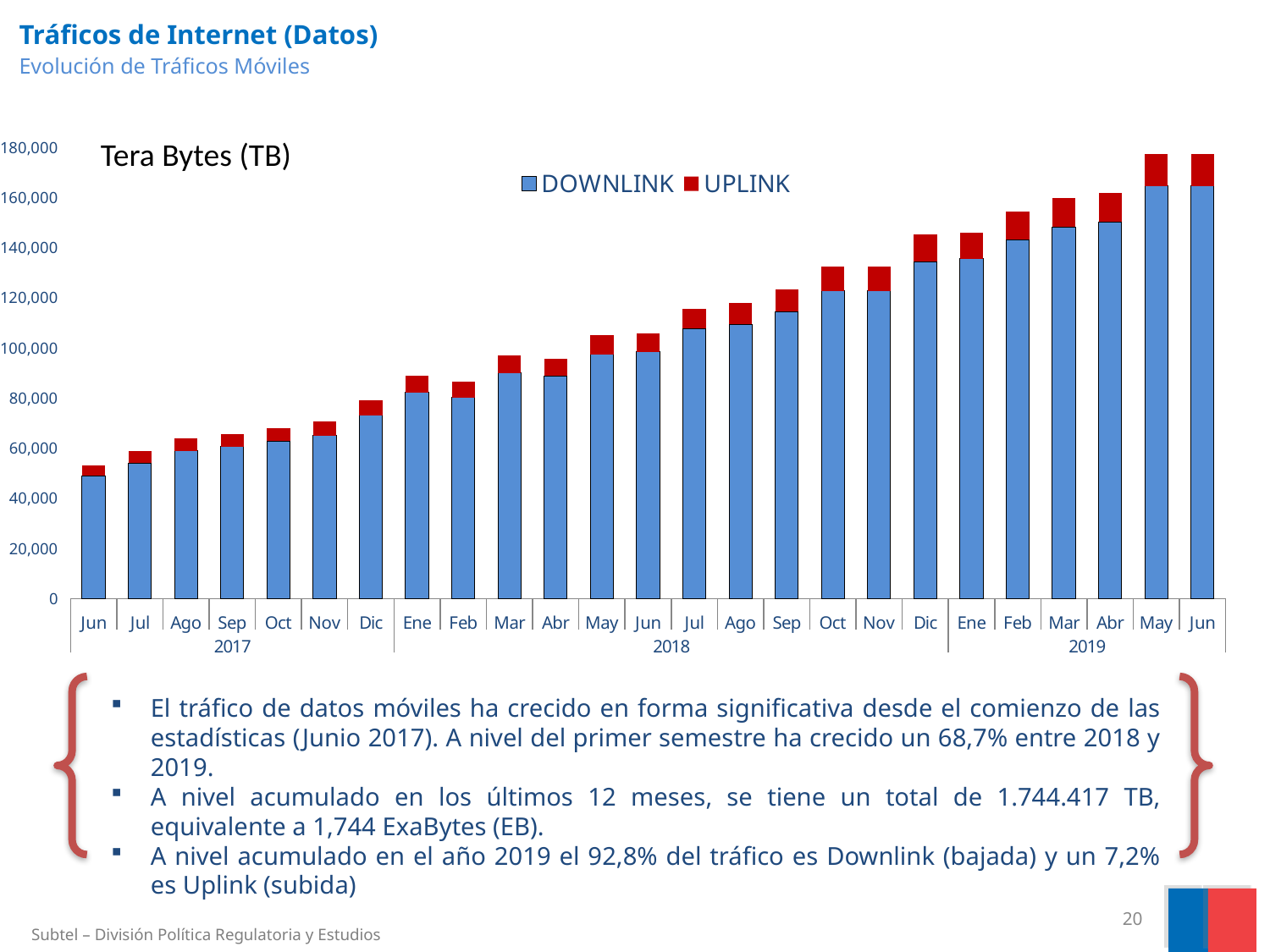
How many series does the chart legend list? 2 In Jun 2019, which series is larger, DOWNLINK or UPLINK? DOWNLINK What colour represents the UPLINK series in the chart? Red Which month has the lowest total traffic in the chart? Jun 2017 Which is larger, the total traffic for Jun 2017 or for Jun 2019? Jun 2019 Do the total traffic values generally rise or fall from Jun 2017 to Jun 2019? Rise Which two series are listed in the chart legend? DOWNLINK and UPLINK Is the total traffic for Jun 2017 greater or less than 60,000? less How many monthly bars are plotted in the chart? 25 Is the total traffic for Jun 2018 greater or less than 100,000? greater Is the total traffic for Jun 2019 greater or less than 160,000? greater What kind of chart is shown on the slide? Stacked bar chart